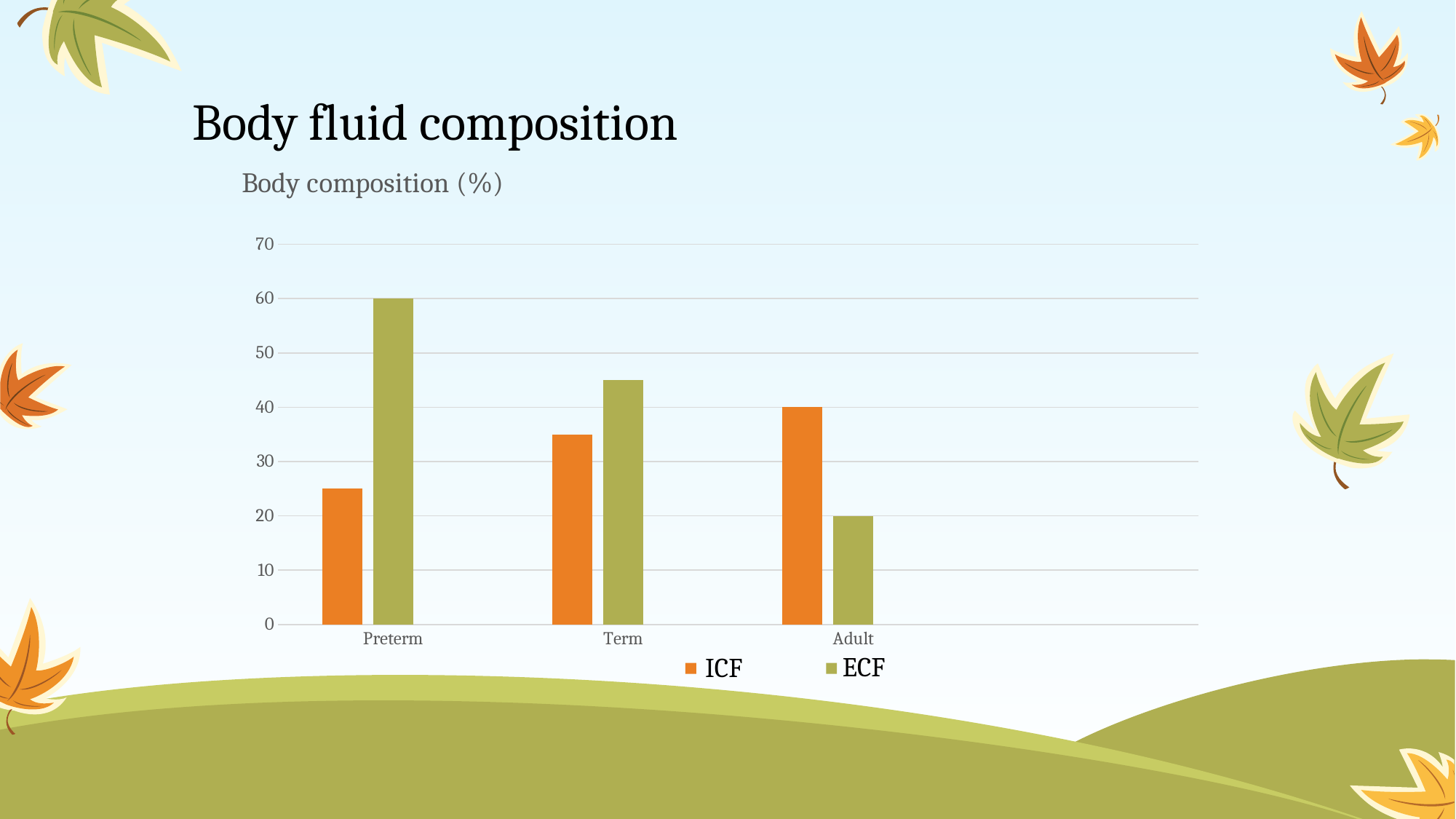
What is the ECF value for Preterm? 60 Does the ECF value rise or fall from Preterm to Adult? fall What is the title of the chart? Body composition (%) What is the difference between the ICF and ECF values for Adult? 20 How many series does the legend list? 2 What is the ECF value for Adult? 20 Is the ICF value for Term greater or less than 30? greater Which category has the lowest ICF value? Preterm What is the ICF value for Adult? 40 How many categories are shown on the x axis? 3 What type of chart is shown on the slide? bar chart Which category has the highest ECF value? Preterm